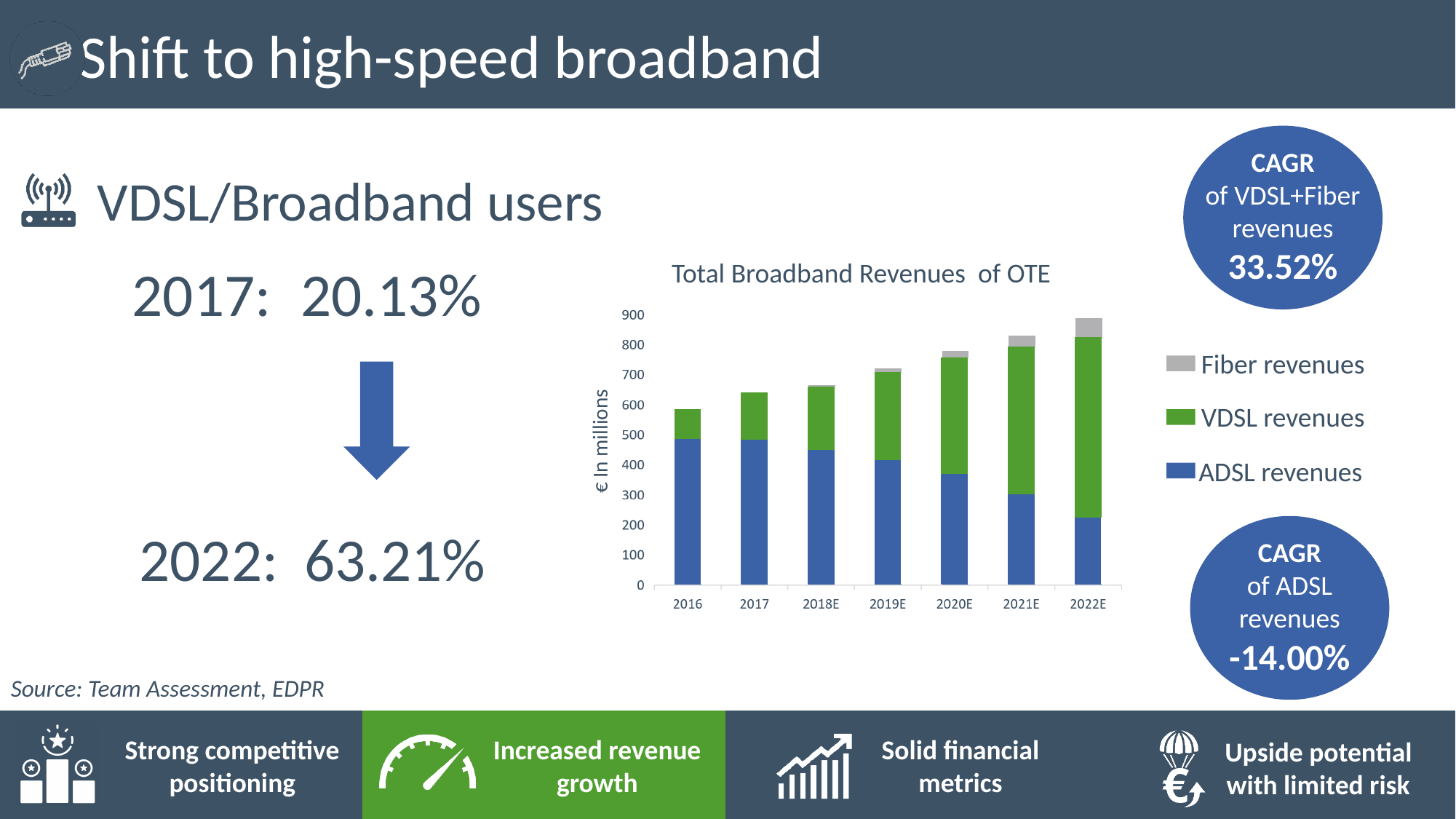
Which year has the lowest total broadband revenue in the chart? 2016 Is the total broadband revenue for 2022E greater or less than 800? greater Do ADSL revenues rise or fall from 2016 to 2022E? Fall What is the label on the y axis of the chart? € In millions Do total broadband revenues rise or fall from 2016 to 2022E? Rise Is the ADSL revenue for 2020E greater or less than 400? less How many years are shown on the x axis of the chart? 7 Which is larger: ADSL revenues in 2016 or ADSL revenues in 2022E? 2016 What kind of chart is shown on the slide? Stacked bar chart Which year has the highest total broadband revenue in the chart? 2022E How many series does the chart's legend list? 3 What is the title of the chart? Total Broadband Revenues of OTE